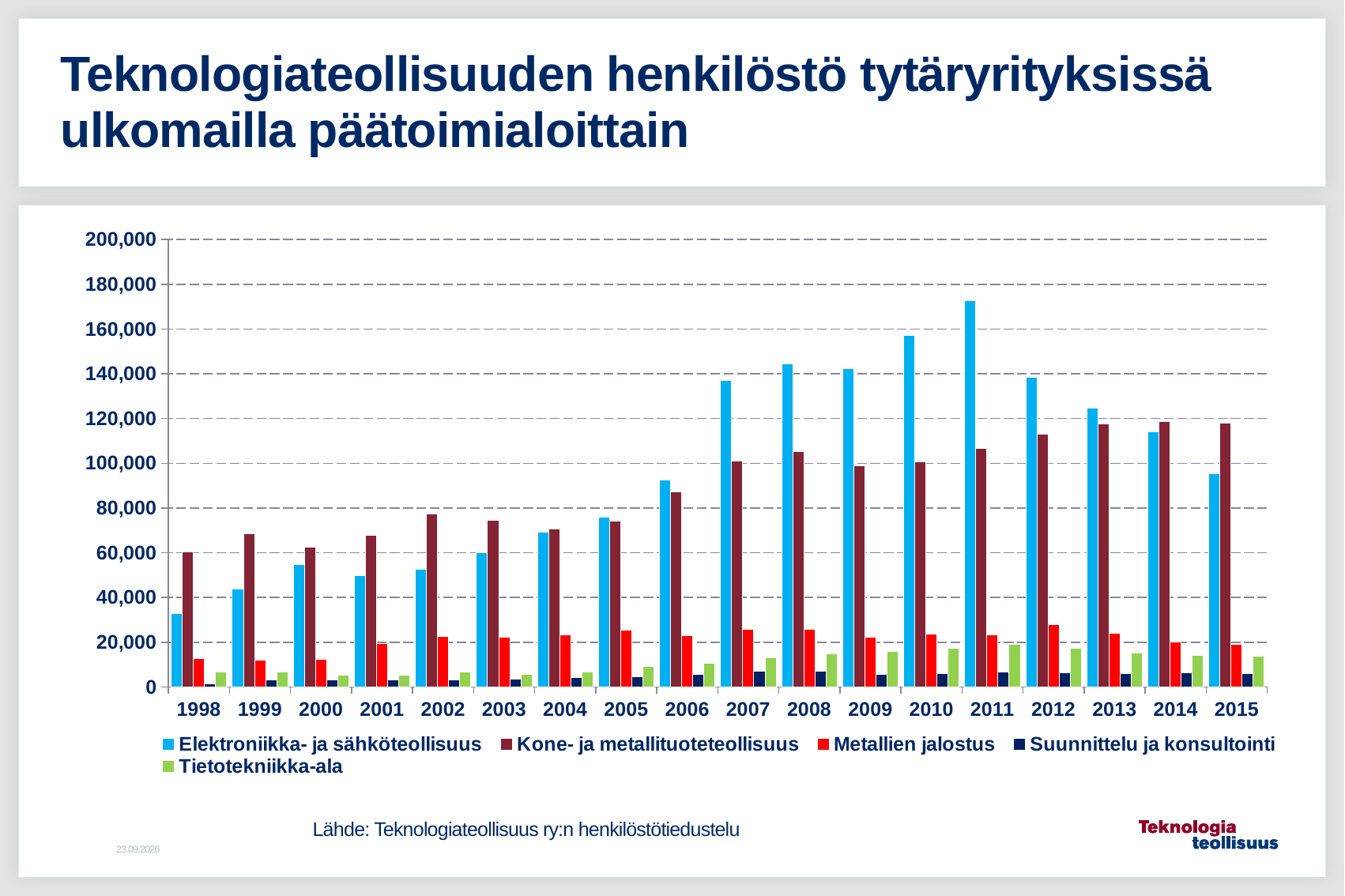
In which year is the value for Elektroniikka- ja sähköteollisuus lowest? 1998 Is the value for Kone- ja metallituoteteollisuus in 2015 greater or less than 100,000? greater Is the value for Elektroniikka- ja sähköteollisuus in 2011 greater or less than 160,000? greater In 2007, which is larger: Elektroniikka- ja sähköteollisuus or Kone- ja metallituoteteollisuus? Elektroniikka- ja sähköteollisuus In 2015, which is larger: Elektroniikka- ja sähköteollisuus or Kone- ja metallituoteteollisuus? Kone- ja metallituoteteollisuus How many years are shown on the x axis? 18 Does the value for Elektroniikka- ja sähköteollisuus rise or fall from 2011 to 2015? fall Is the value for Elektroniikka- ja sähköteollisuus in 1998 greater or less than 40,000? less What kind of chart is shown on the slide? bar chart What colour represents Tietotekniikka-ala in the legend? green In which year is the value for Elektroniikka- ja sähköteollisuus highest? 2011 How many series does the legend list? 5